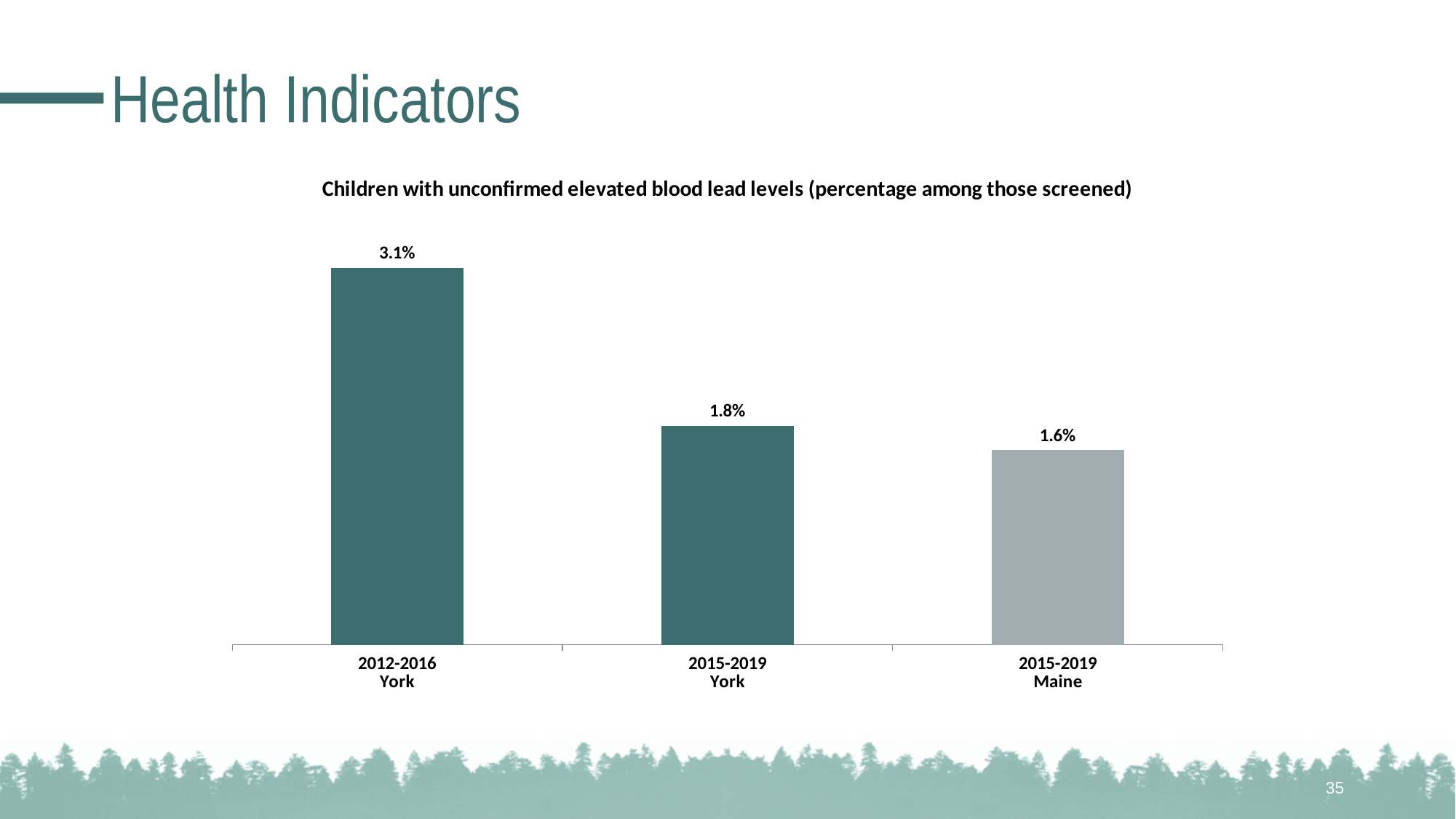
What is the title of the chart? Children with unconfirmed elevated blood lead levels (percentage among those screened) What is the value for 2015-2019 York? 1.8% What is the value for 2012-2016 York? 3.1% What is the difference between the 2012-2016 York value and the 2015-2019 York value? 1.3% What kind of chart is shown on the slide? Bar chart How many bars are shown in the chart? 3 Which category has the highest value? 2012-2016 York Which category has the lowest value? 2015-2019 Maine What is the value for 2015-2019 Maine? 1.6% What is the difference between the 2015-2019 York value and the 2015-2019 Maine value? 0.2% Which is larger, the value for 2015-2019 York or the value for 2015-2019 Maine? 2015-2019 York Do the values rise or fall from left to right across the chart? Fall